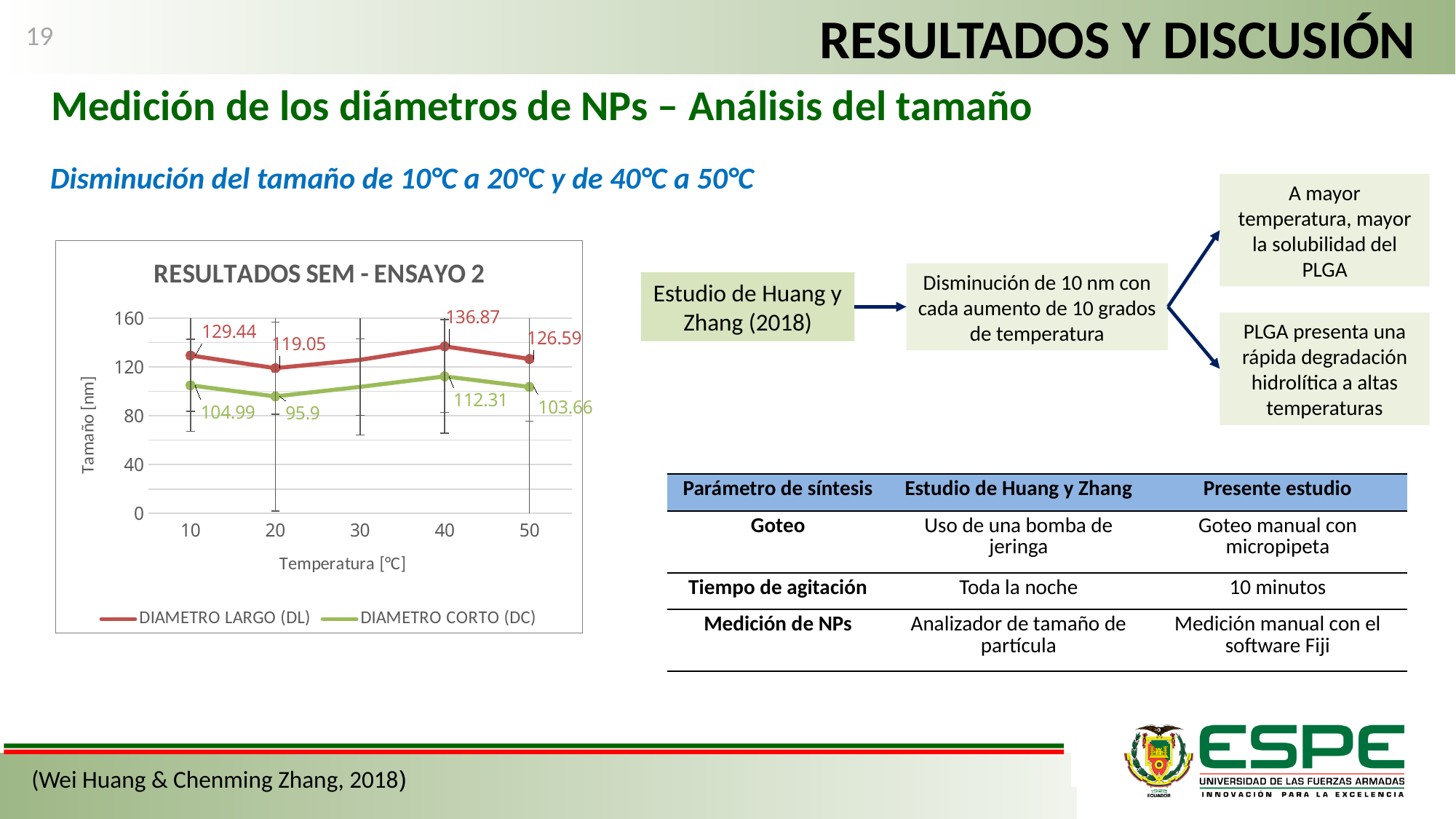
What is the value of DIAMETRO CORTO (DC) at 20 °C? 95.9 Does DIAMETRO LARGO (DL) rise or fall from 10 °C to 20 °C? fall At which temperature is DIAMETRO LARGO (DL) highest? 40 What kind of chart is shown on the slide? line chart What is the difference between DIAMETRO LARGO (DL) and DIAMETRO CORTO (DC) at 40 °C? 24.56 How many series does the legend list? 2 What is the value of DIAMETRO LARGO (DL) at 50 °C? 126.59 What is the difference between DIAMETRO LARGO (DL) at 40 °C and at 20 °C? 17.82 Is the value of DIAMETRO CORTO (DC) at 40 °C greater or less than 120? less At which temperature is DIAMETRO CORTO (DC) lowest? 20 What is the value of DIAMETRO LARGO (DL) at 10 °C? 129.44 Which is larger for DIAMETRO LARGO (DL): the value at 10 °C or at 50 °C? 10 °C